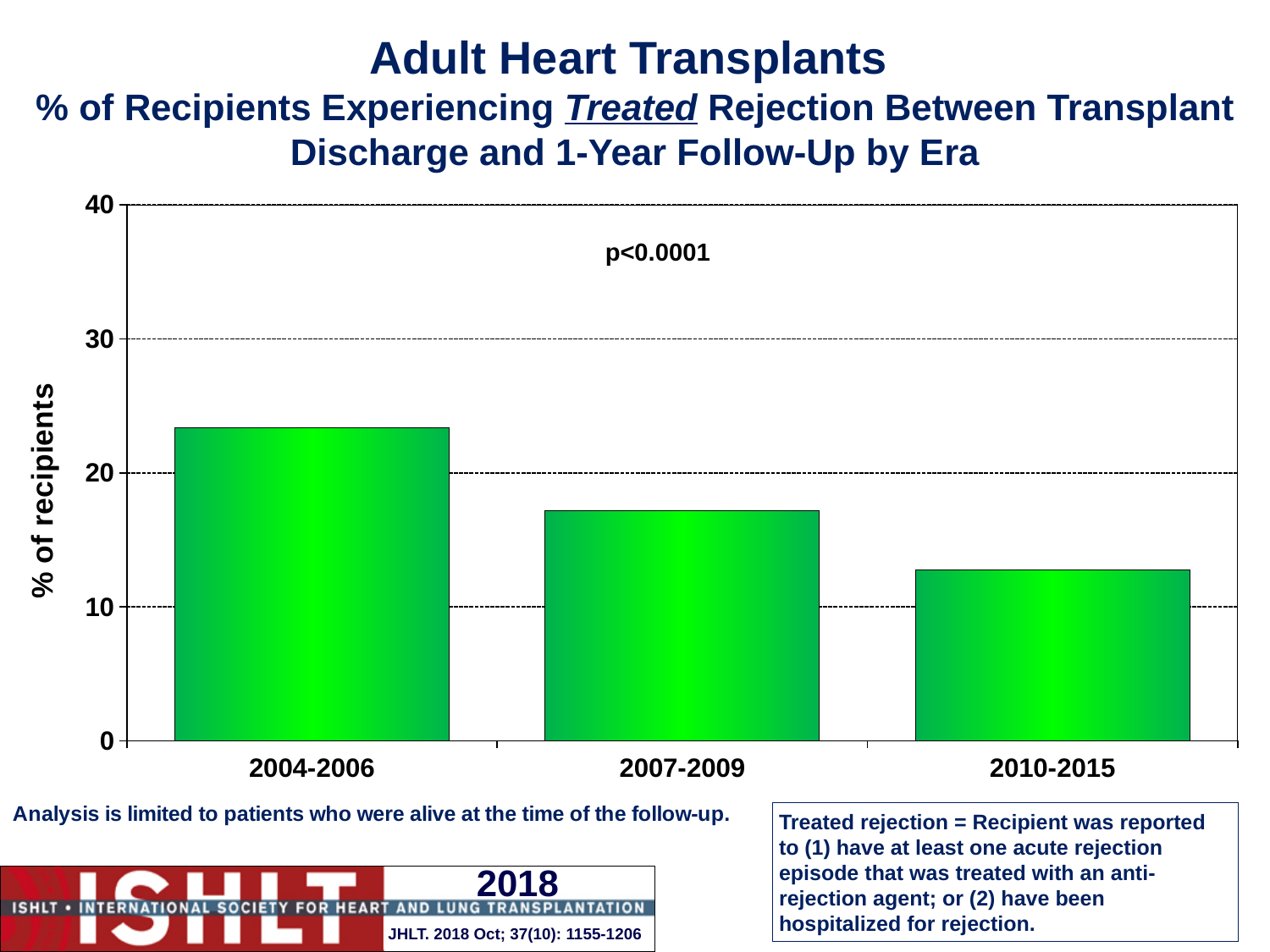
What p-value is printed on the chart? p<0.0001 Which era has the highest % of recipients experiencing treated rejection? 2004-2006 Which is larger, the value for 2007-2009 or the value for 2010-2015? 2007-2009 What kind of chart is shown on the slide? bar chart Which is larger, the value for 2004-2006 or the value for 2007-2009? 2004-2006 What is the label on the y axis? % of recipients Is the value for 2007-2009 greater or less than 20? less Do the values rise or fall from 2004-2006 to 2010-2015? fall How many era categories are plotted on the x axis? 3 Is the value for 2010-2015 greater or less than 10? greater Is the value for 2004-2006 greater or less than 20? greater Which era has the lowest % of recipients experiencing treated rejection? 2010-2015